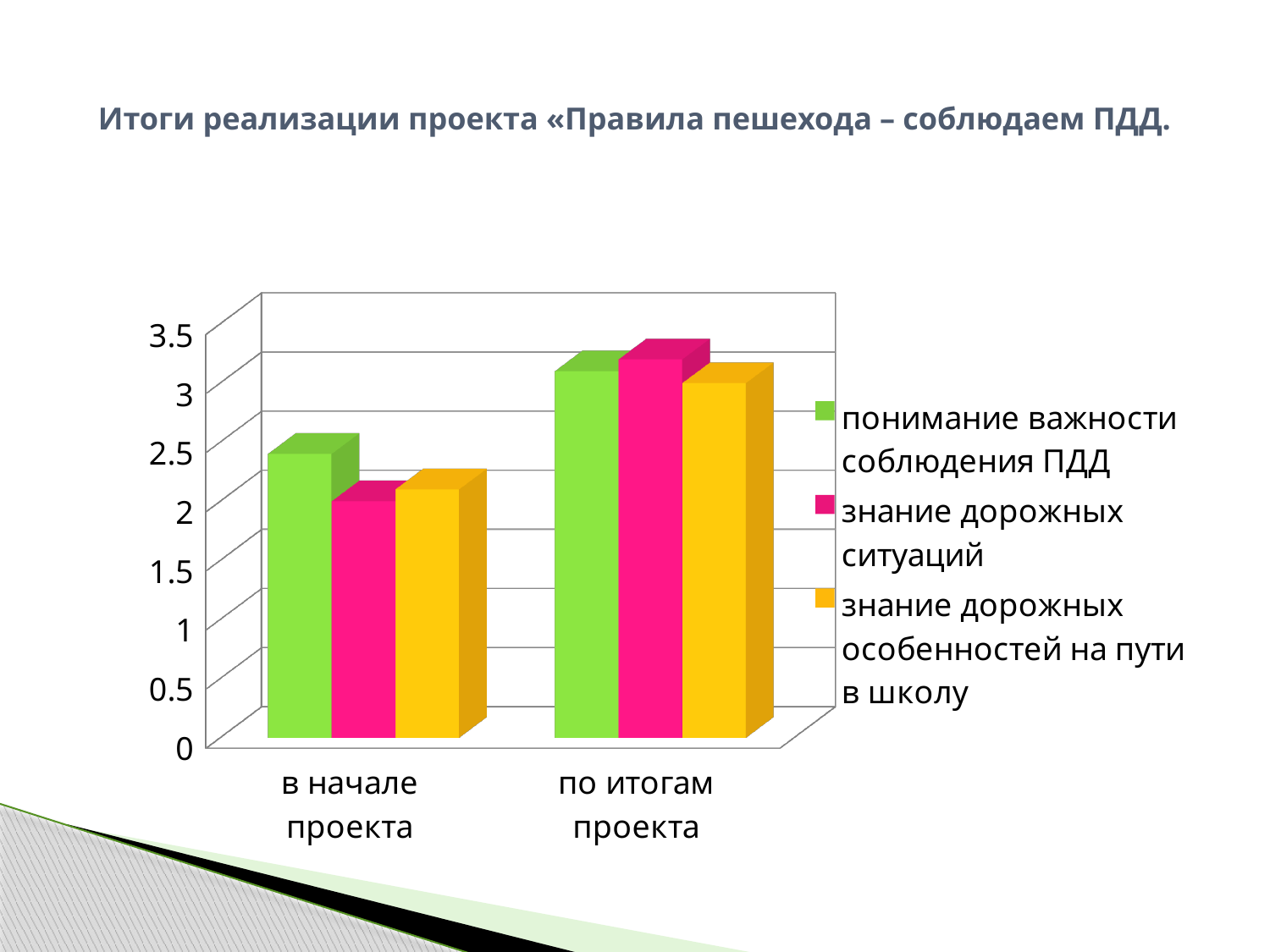
Which is larger at "в начале проекта": "понимание важности соблюдения ПДД" or "знание дорожных ситуаций"? понимание важности соблюдения ПДД Which colour represents "знание дорожных особенностей на пути в школу" in the chart? yellow Which series has the highest value for "в начале проекта"? понимание важности соблюдения ПДД How many series does the chart's legend list? 3 How many categories are shown on the x axis of the chart? 2 Do the values for "знание дорожных ситуаций" rise or fall from "в начале проекта" to "по итогам проекта"? rise What kind of chart is shown on the slide? bar chart Is the value for "знание дорожных ситуаций" at "в начале проекта" greater or less than 1.5? greater Is the value for "знание дорожных ситуаций" at "по итогам проекта" greater or less than 3? greater Is the value for "понимание важности соблюдения ПДД" at "в начале проекта" greater or less than 2? greater What is the title of the slide containing the chart? Итоги реализации проекта «Правила пешехода – соблюдаем ПДД.